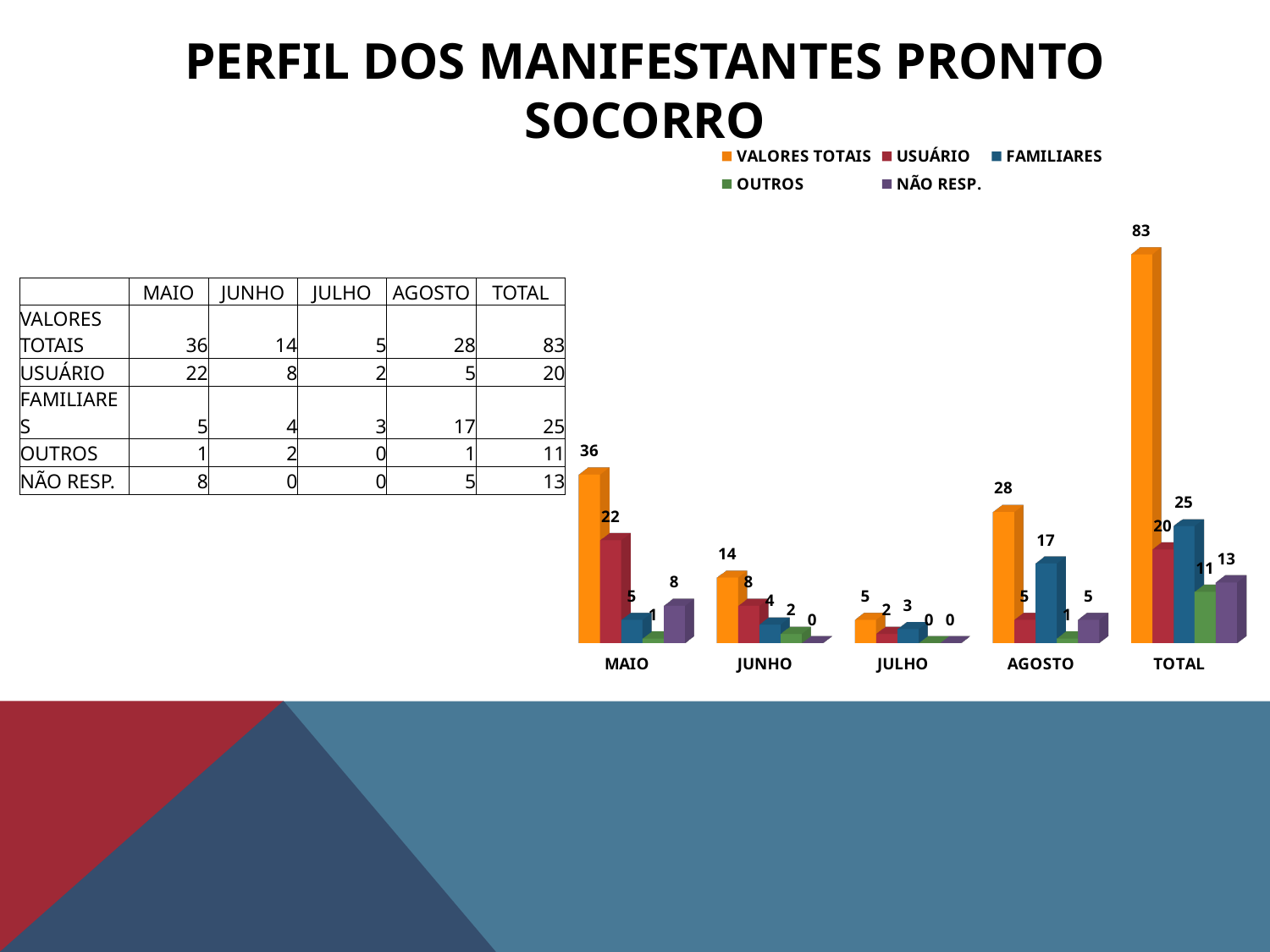
How many series does the chart legend list? 5 What is the value of NÃO RESP. for TOTAL? 13 What is the value of VALORES TOTAIS for MAIO? 36 Which series is shown in orange in the chart legend? VALORES TOTAIS Which month (excluding TOTAL) has the lowest VALORES TOTAIS value? JULHO What is the value of USUÁRIO for JUNHO? 8 What is the value of FAMILIARES for AGOSTO? 17 Which is larger, USUÁRIO for MAIO or FAMILIARES for AGOSTO? USUÁRIO for MAIO How many categories are shown along the x axis of the chart? 5 What type of chart is shown on the slide? bar chart Which category has the highest VALORES TOTAIS value? TOTAL What is the difference between VALORES TOTAIS for MAIO and for AGOSTO? 8